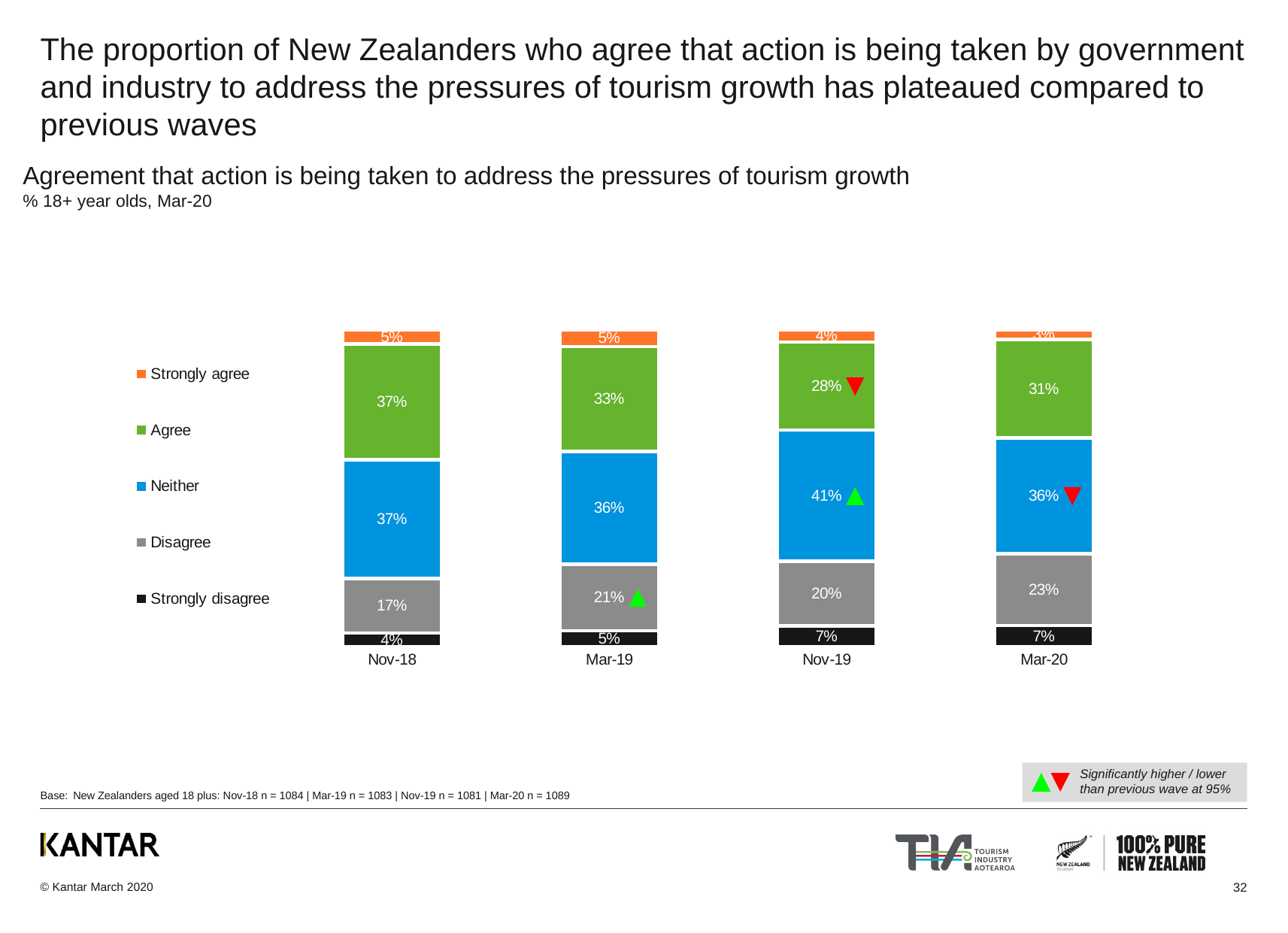
What kind of chart is shown on the slide? Stacked bar chart By how many percentage points is 'Disagree' higher in Mar-20 than in Nov-18? 6 percentage points In which wave is the 'Agree' segment the lowest? Nov-19 Does the 'Strongly disagree' value rise or fall from Nov-18 to Mar-20? Rises What is the 'Neither' value for Nov-19? 41% How many series does the legend list? 5 How many survey waves are shown on the x axis? 4 What percentage chose 'Disagree' in Mar-20? 23% Which wave has the larger 'Agree' value, Mar-19 or Mar-20? Mar-19 In which wave is the 'Neither' segment the highest? Nov-19 What is the 'Strongly disagree' value for Mar-19? 5% What percentage of respondents chose 'Agree' in Nov-18? 37%